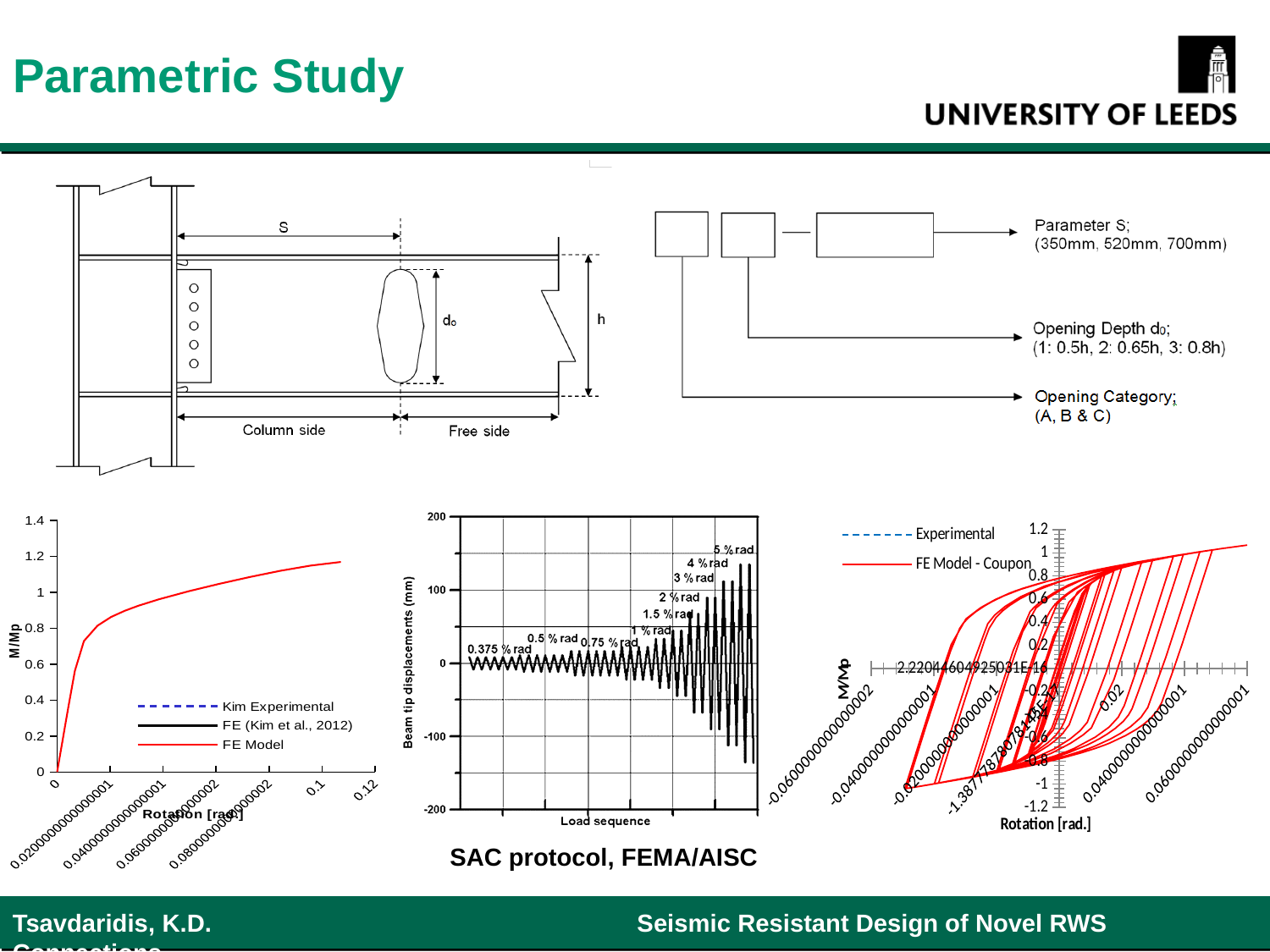
On the right chart (hysteresis loops, M/Mp vs Rotation), how many series does the legend list? 2 On the left chart (M/Mp vs Rotation), how many series does the legend list? 3 On the left chart (M/Mp vs Rotation), what are the three legend entries? Kim Experimental, FE (Kim et al., 2012), FE Model On the left chart (M/Mp vs Rotation), does M/Mp rise or fall as rotation increases? rise On the middle chart (Beam tip displacements vs Load sequence), what is the label of the vertical axis? Beam tip displacements (mm) On the middle chart (Beam tip displacements vs Load sequence), which labelled rotation amplitude level is the smallest? 0.375 % rad On the middle chart (Beam tip displacements vs Load sequence), is the peak beam tip displacement at the 5 % rad level greater or less than 100 mm? greater On the left chart (M/Mp vs Rotation), what is the highest value shown on the vertical axis? 1.4 On the left chart (M/Mp vs Rotation), what kind of chart is it? line chart On the middle chart (Beam tip displacements vs Load sequence), which labelled rotation amplitude level is the largest? 5 % rad On the middle chart (Beam tip displacements vs Load sequence), how many rotation amplitude levels are labelled on the plot? 9 On the left chart (M/Mp vs Rotation), is the M/Mp value of the FE Model curve at a rotation of 0.1 greater or less than 1? greater